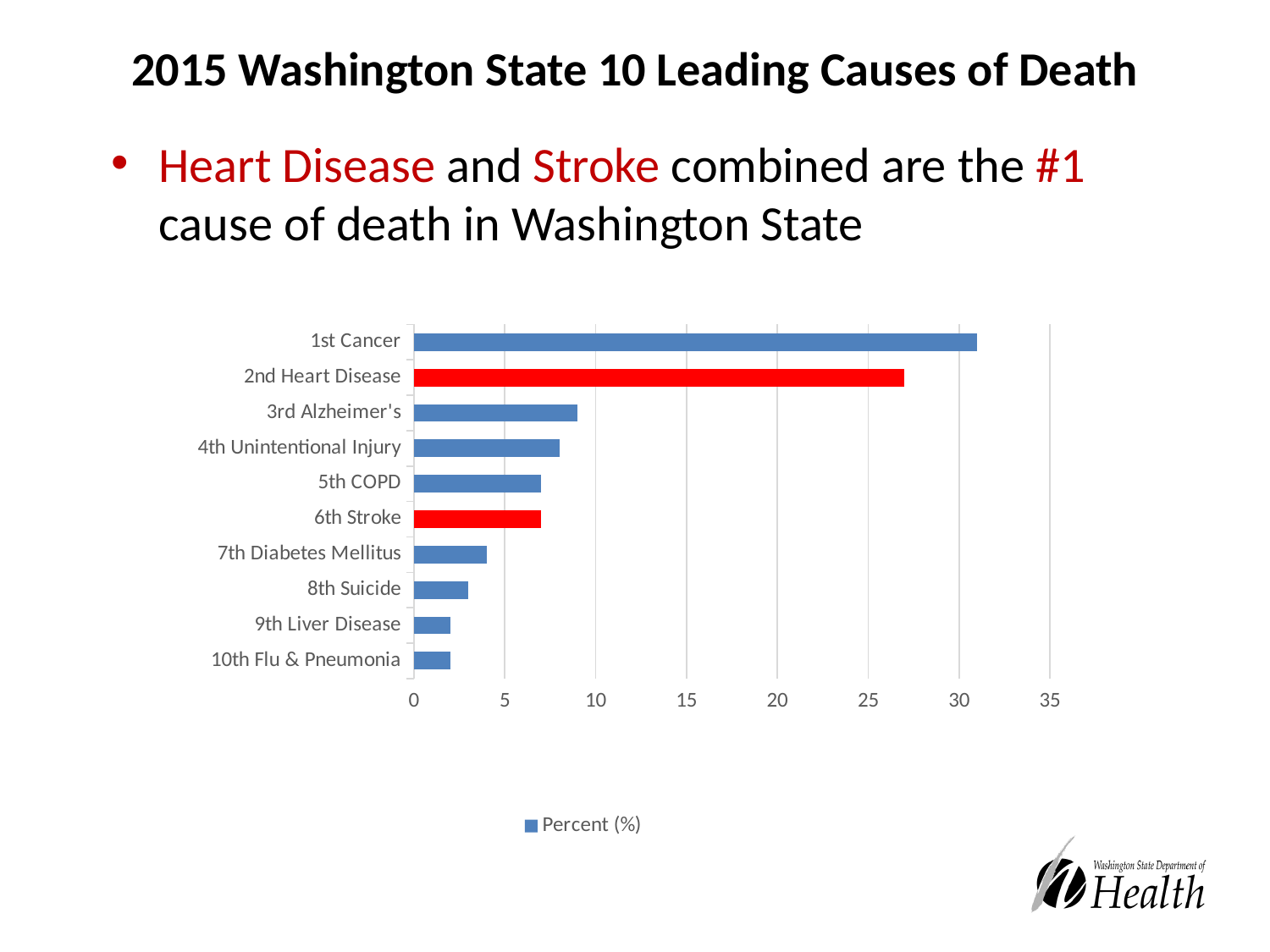
Is the value for 7th Diabetes Mellitus greater or less than 5? less How many series does the chart legend list? 1 How many causes of death are plotted in the chart? 10 Which is larger, the value for 2nd Heart Disease or the value for 6th Stroke? 2nd Heart Disease Is the value for 2nd Heart Disease greater or less than 25? greater Which is larger, the value for 4th Unintentional Injury or the value for 8th Suicide? 4th Unintentional Injury Which cause of death has the highest percentage in the chart? 1st Cancer Is the value for 3rd Alzheimer's greater or less than 10? less Which two bars in the chart are coloured red? 2nd Heart Disease and 6th Stroke What kind of chart is shown on the slide? bar chart What is the name of the series shown in the chart legend? Percent (%)